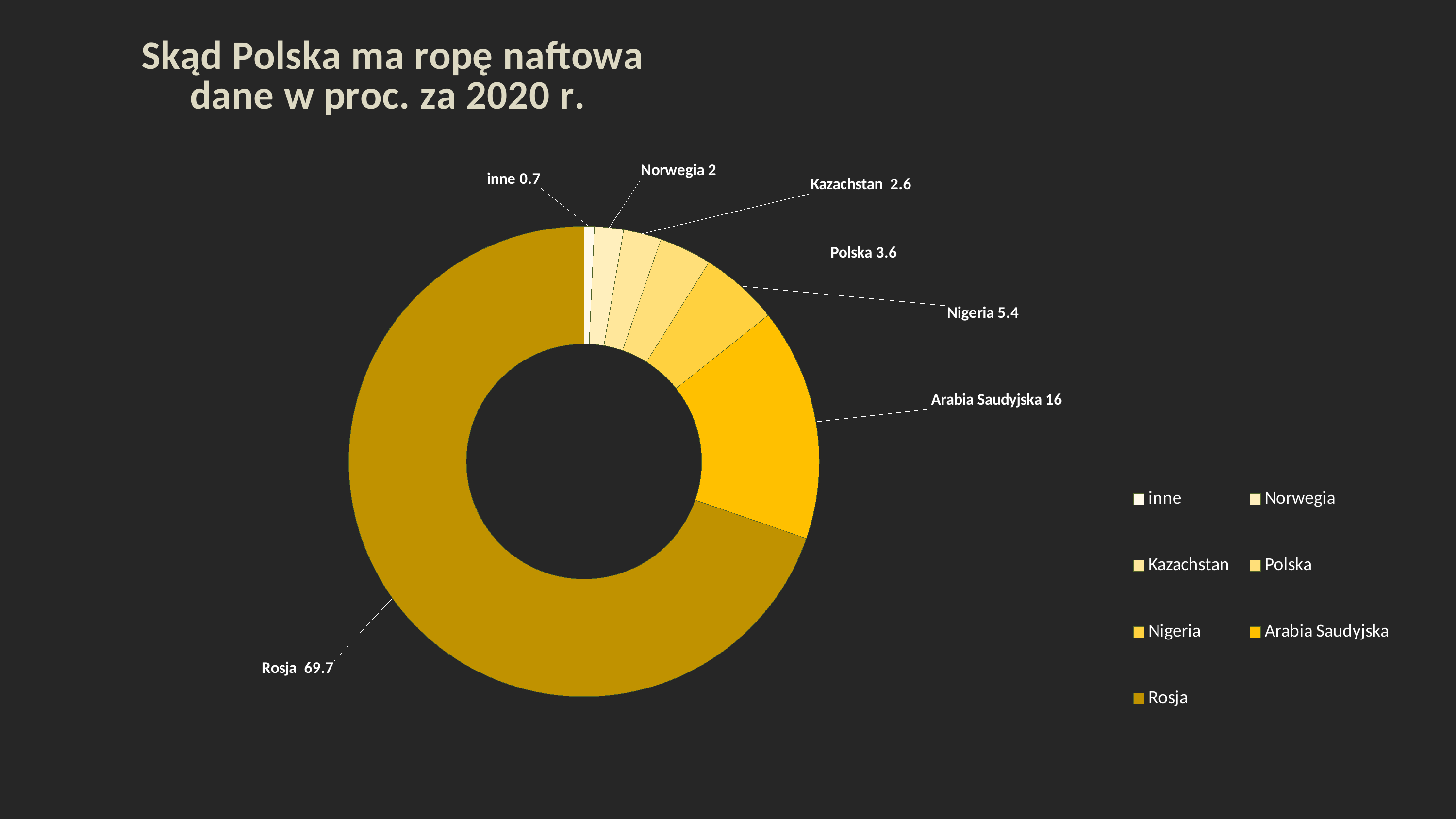
What is the difference between the values for Nigeria and Polska? 1.8 What value is shown for Nigeria? 5.4 What is the difference between the values for Rosja and Arabia Saudyjska? 53.7 Which category has the smallest slice? inne Which category has the largest slice? Rosja What value is shown for Kazachstan? 2.6 What value is shown for Rosja? 69.7 What kind of chart is shown on the slide? Doughnut (pie) chart What is the title of the chart? Skąd Polska ma ropę naftowa dane w proc. za 2020 r. How many categories does the chart show? 7 What value is shown for Arabia Saudyjska? 16 Which is larger, the value for Polska or the value for Norwegia? Polska